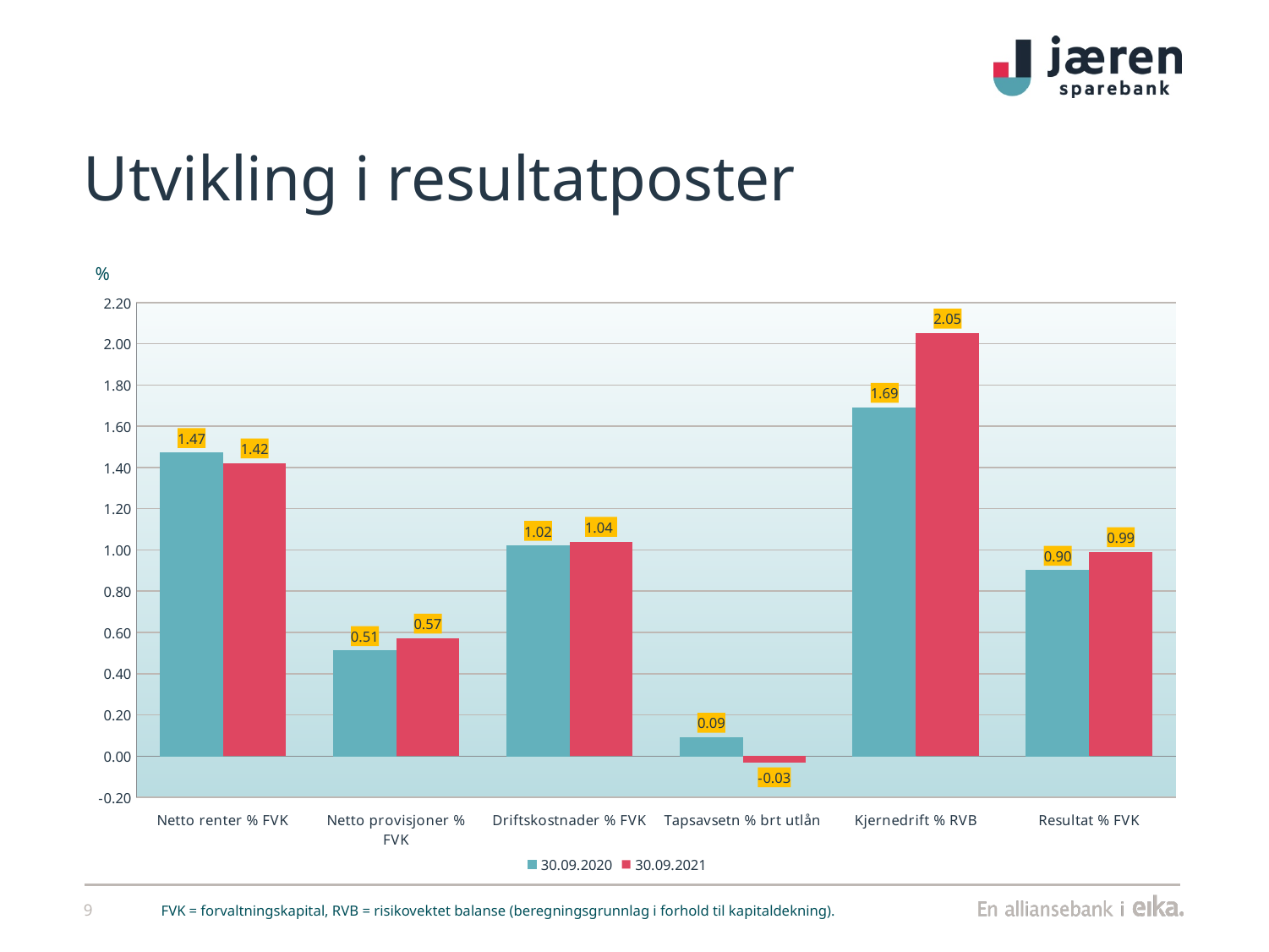
Which category has the highest value in the 30.09.2021 series? Kjernedrift % RVB How many series does the legend list? 2 What is the value for Kjernedrift % RVB for the 30.09.2021 series? 2.05 What is the title of the slide? Utvikling i resultatposter What kind of chart is shown on the slide? Bar chart For Netto renter % FVK, which series has the larger value, 30.09.2020 or 30.09.2021? 30.09.2020 What is the value for Tapsavsetn % brt utlån for the 30.09.2021 series? -0.03 What is the value for Resultat % FVK for the 30.09.2020 series? 0.90 Which category has the lowest value in the 30.09.2020 series? Tapsavsetn % brt utlån What is the difference between the 30.09.2021 and 30.09.2020 values for Kjernedrift % RVB? 0.36 How many categories are shown on the x axis? 6 What is the value for Netto renter % FVK for the 30.09.2020 series? 1.47